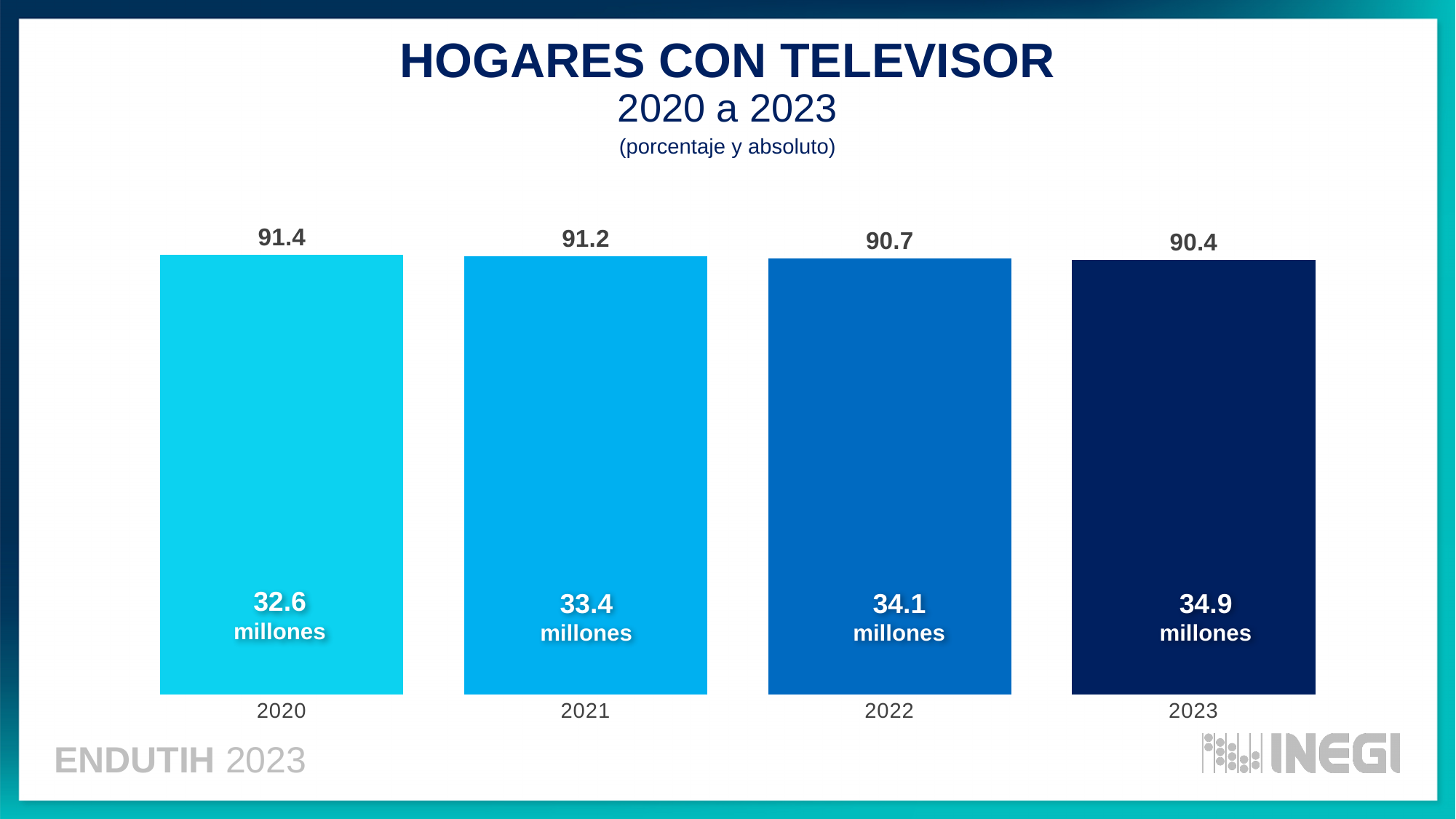
Do the percentage values rise or fall from 2020 to 2023? Fall What is the difference in millions of households between 2023 and 2020? 2.3 millones Which year has more households with a television in absolute terms, 2021 or 2022? 2022 Which year has the lowest percentage of households with a television? 2023 What absolute number of households (in millions) is shown inside the bar for 2022? 34.1 millones What kind of chart is shown on the slide? Bar chart What is the percentage value shown above the bar for 2020? 91.4 How many years (categories) are shown in the chart? 4 What absolute number of households (in millions) is shown inside the bar for 2021? 33.4 millones What is the difference between the percentage values for 2020 and 2023? 1.0 What is the percentage value shown above the bar for 2023? 90.4 Which year has the highest percentage of households with a television? 2020